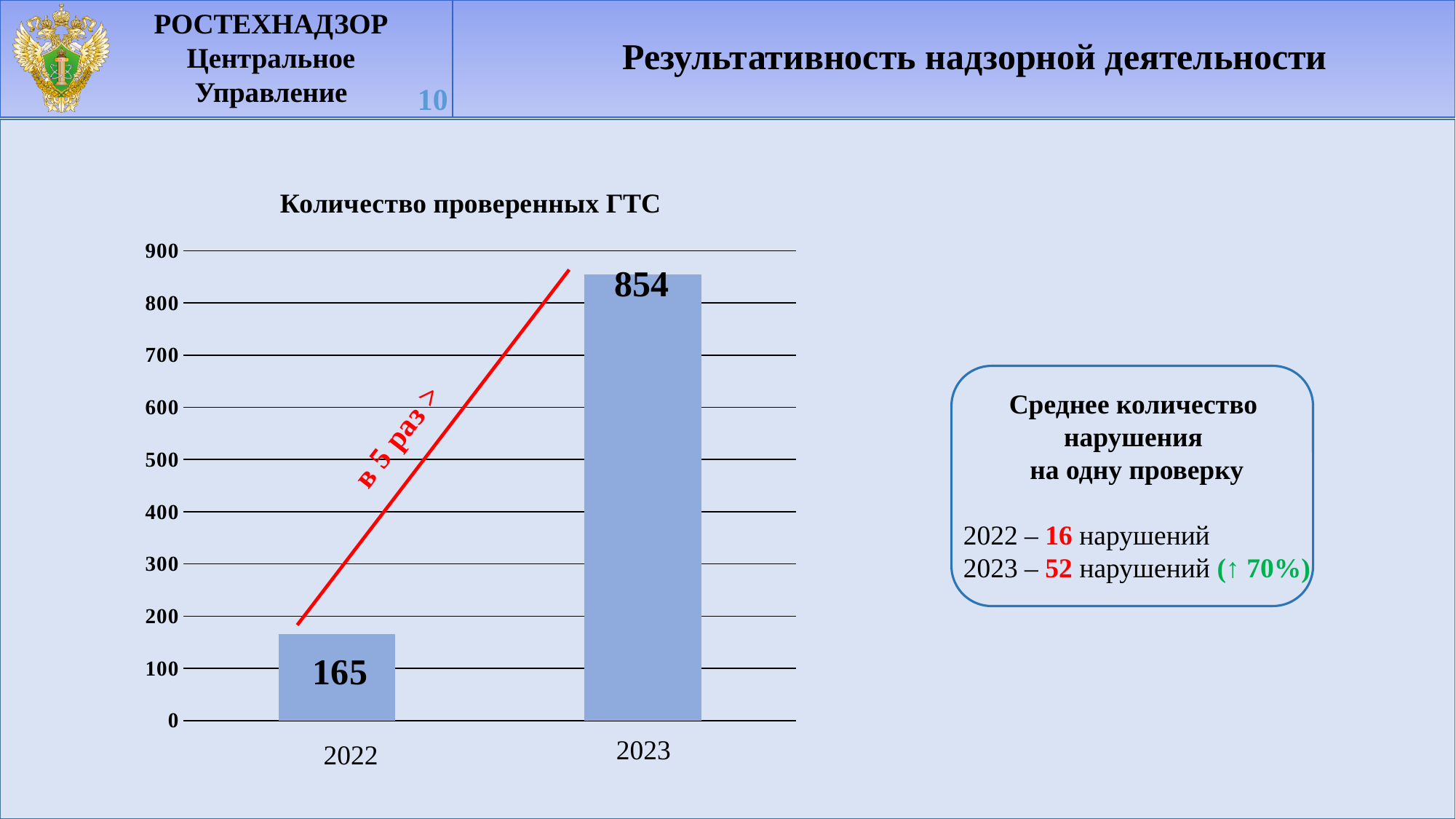
What is the value for 2022 in the chart? 165 Is the value for 2023 greater or less than 800? greater What is the title of the chart? Количество проверенных ГТС What is the value for 2023 in the chart? 854 Is the value for 2022 greater or less than 200? less Do the values rise or fall from 2022 to 2023? rise How many categories are shown on the x axis of the chart? 2 Which year has the highest value in the chart? 2023 What kind of chart is shown on the slide? bar chart Which is larger, the value for 2022 or the value for 2023? 2023 Which year has the lowest value in the chart? 2022 What is the difference between the values for 2023 and 2022? 689